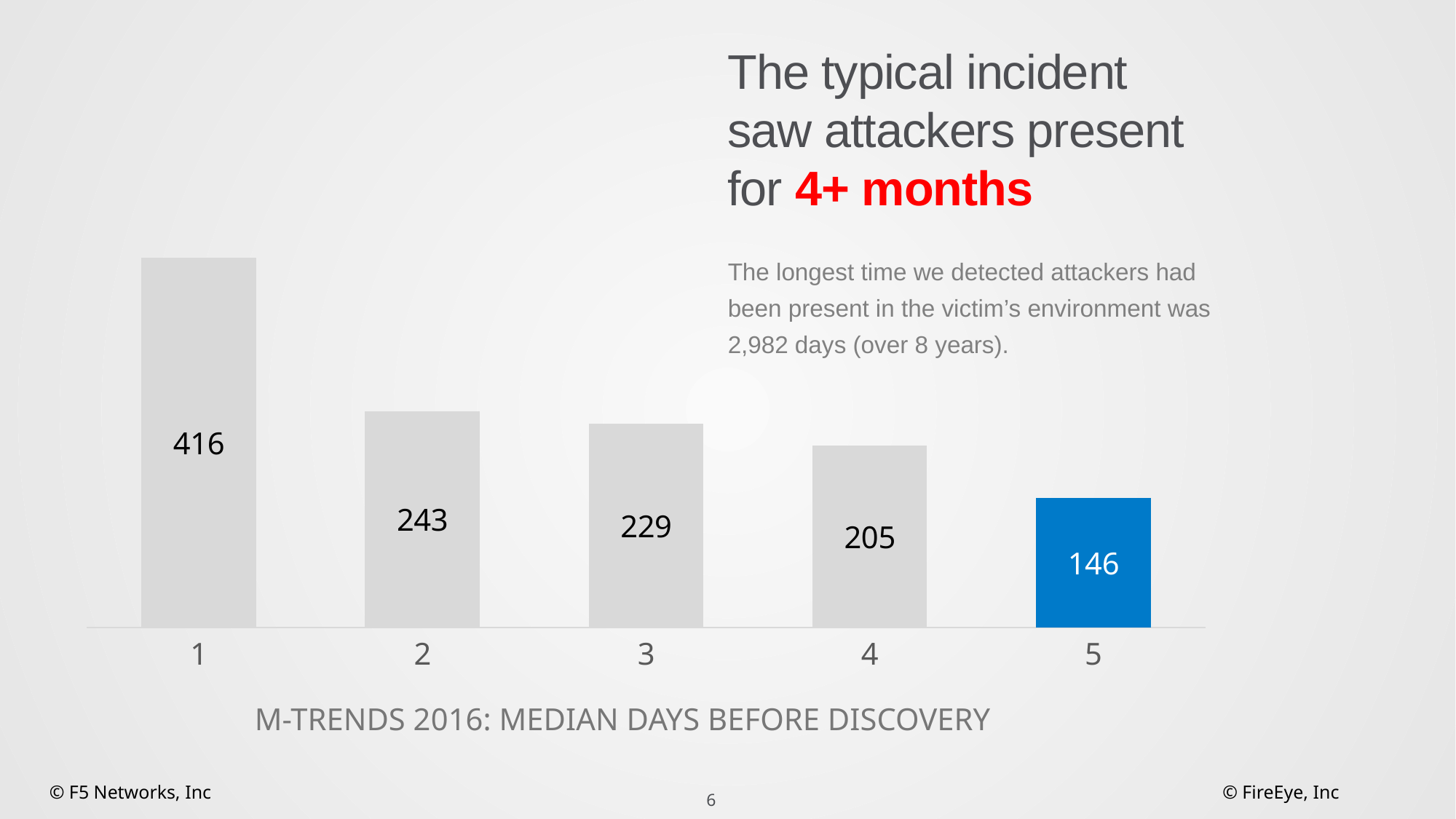
What is the value for category 1? 416 Which category has the highest value? 1 What is the difference between the values for category 1 and category 2? 173 Which bar is coloured blue rather than grey? 5 What is the value for category 5? 146 Which is larger, the value for category 2 or the value for category 3? 2 What kind of chart is shown on the slide? bar chart What is the value for category 3? 229 How many bars are in the chart? 5 What is the difference between the values for category 4 and category 5? 59 Which category has the lowest value? 5 Do the values rise or fall from category 1 to category 5? fall